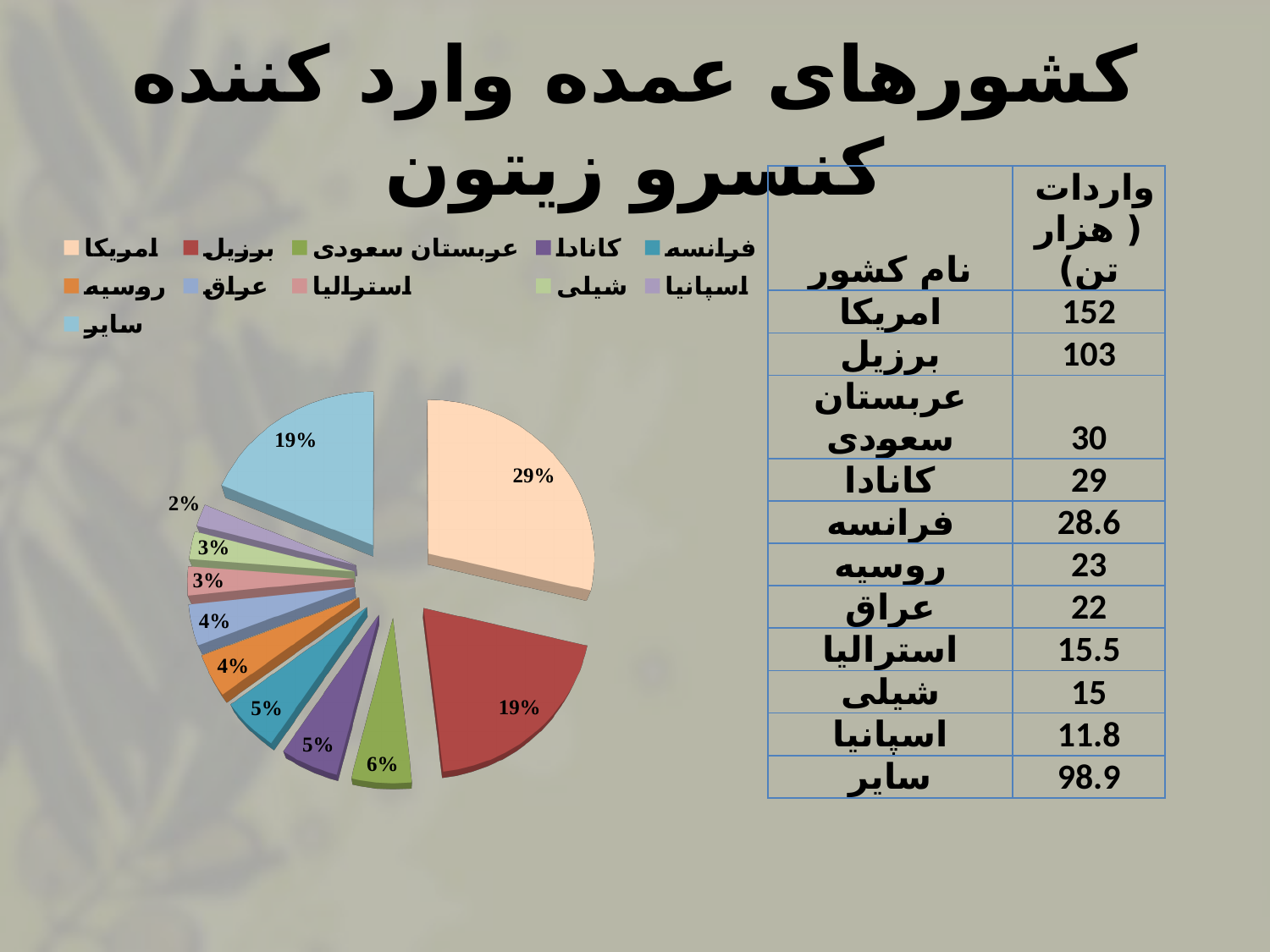
What is the difference in percentage points between the امریکا slice and the برزیل slice? 10 What percentage of the pie does برزیل account for? 19% How many entries does the legend of the pie chart list? 11 What kind of chart is shown on the slide? pie chart What percentage of the pie does امریکا account for? 29% What percentage of the pie does سایر account for? 19% How many slices does the pie chart have? 11 Which slice of the pie chart is the largest? امریکا Which slice is larger in the pie chart, امریکا or برزیل? امریکا Which slice of the pie chart is the smallest? اسپانیا